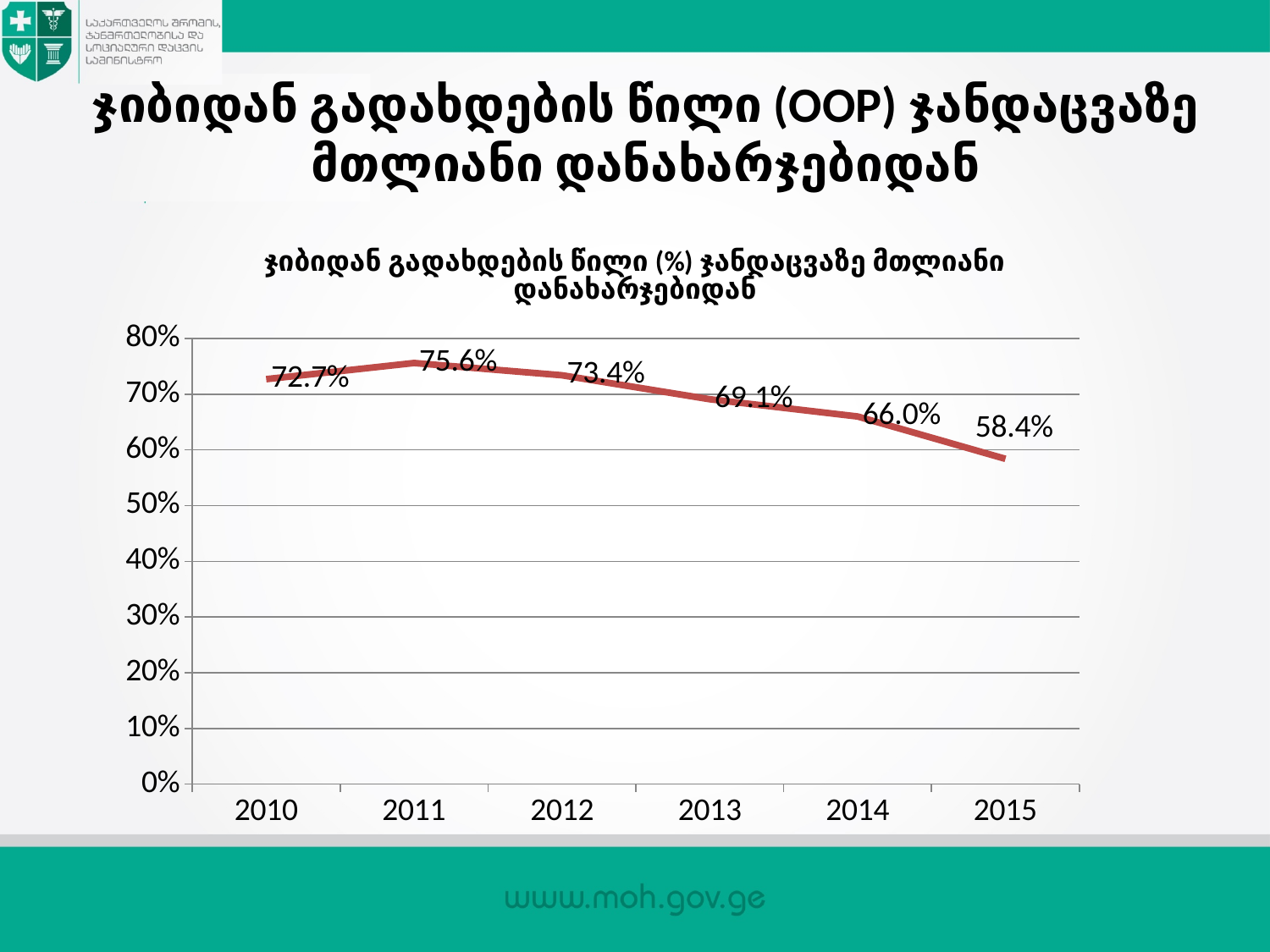
Which year has the lowest value? 2015 How many years are plotted on the chart? 6 What kind of chart is shown? line chart What is the value for 2015? 58.4% Do the values rise or fall from 2011 to 2015? fall Which year has the highest value? 2011 What is the value for 2013? 69.1% What is the value for 2010? 72.7% Which is larger, the value for 2012 or the value for 2014? 2012 What is the difference between the values for 2011 and 2015? 17.2% Is the value for 2015 greater or less than 60%? less What colour is the line on the chart? red